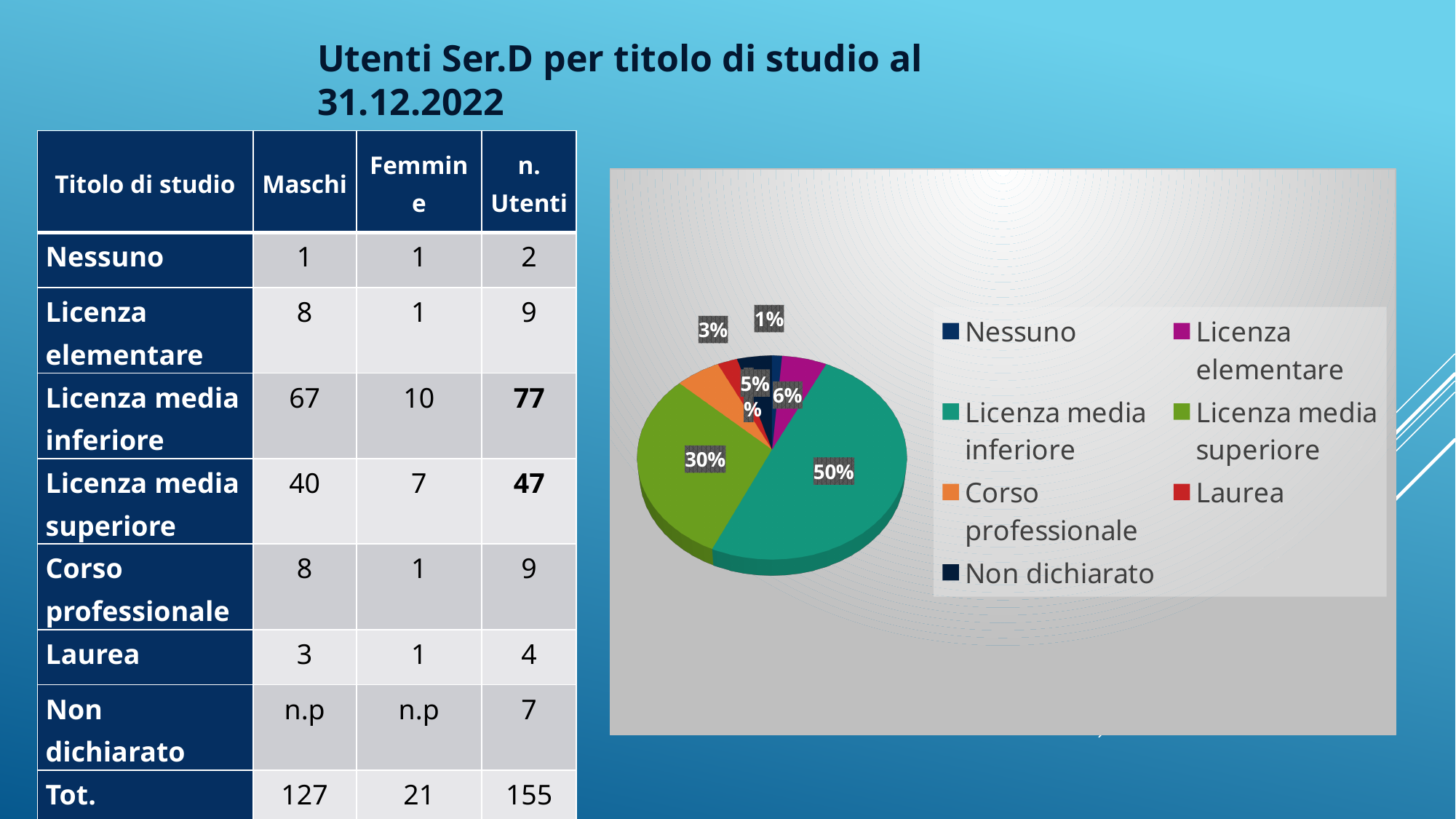
Which category has the largest slice of the pie? Licenza media inferiore How many categories does the pie chart legend list? 7 By how many percentage points does the Licenza media inferiore slice exceed the Licenza media superiore slice? 20 What share of the pie does Nessuno represent? 1% What is the title of the slide above the chart? Utenti Ser.D per titolo di studio al 31.12.2022 Which slice is larger, Licenza media superiore or Nessuno? Licenza media superiore What share of the pie does Licenza media superiore represent? 30% What share of the pie does Licenza media inferiore represent? 50% Which category has the smallest slice of the pie? Nessuno What kind of chart is shown on the slide? pie chart What colour represents Laurea in the pie chart legend? red Is the share for Licenza media superiore greater or less than 50%? less